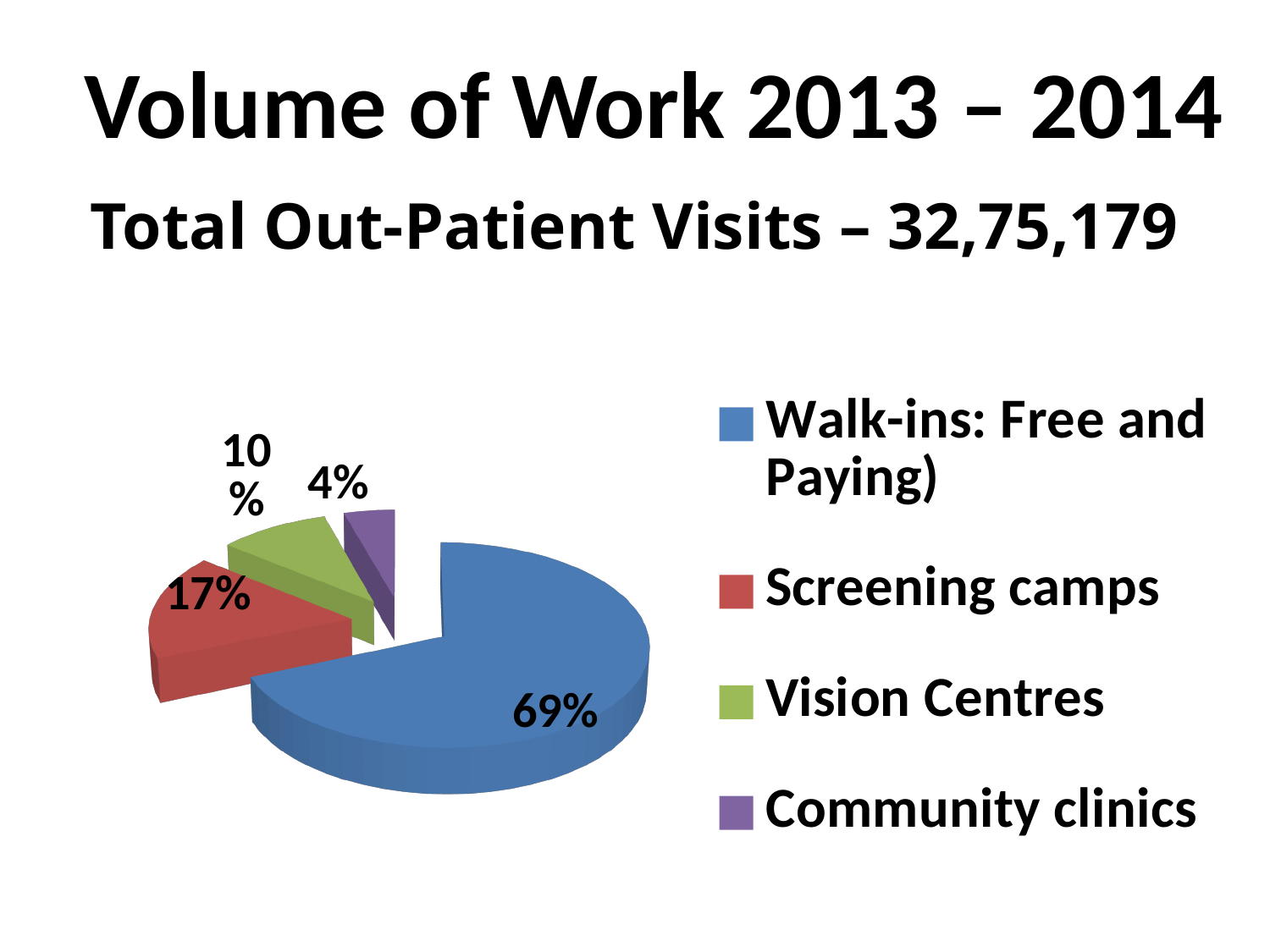
What share of the pie is Community clinics? 4% What kind of chart is shown on the slide? pie chart What share of the pie is Walk-ins: Free and Paying)? 69% What colour is the slice for Vision Centres? green Which category has the largest slice of the pie? Walk-ins: Free and Paying) How many categories does the pie chart show? 4 Which category has the smallest slice of the pie? Community clinics What share of the pie is Screening camps? 17% What is the difference in percentage points between Screening camps and Vision Centres? 7 Which is larger, the share for Screening camps or the share for Community clinics? Screening camps What is the total out-patient visits figure stated on the slide? 32,75,179